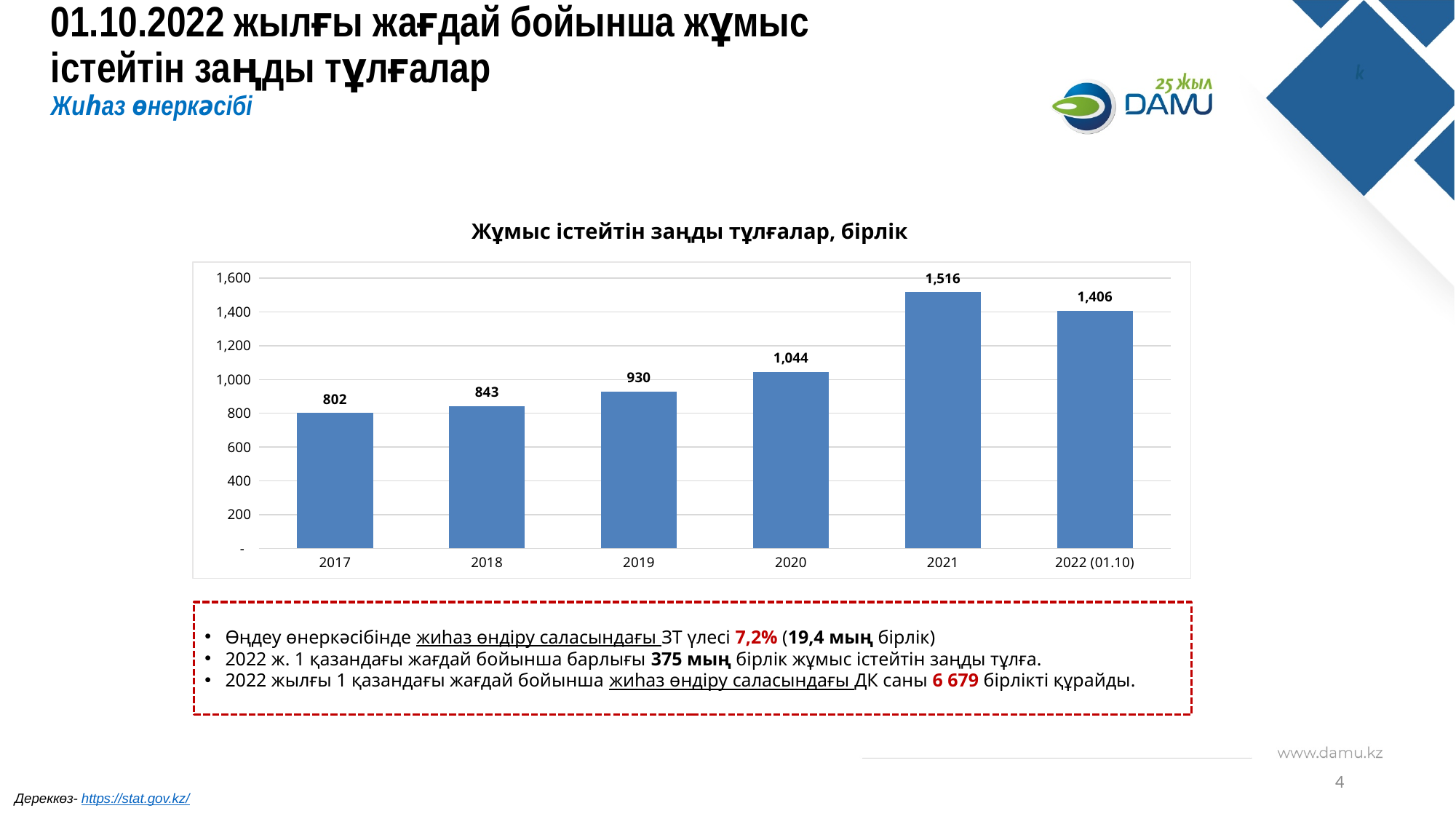
What is the title of the chart? Жұмыс істейтін заңды тұлғалар, бірлік What is the difference between the values for 2021 and 2022 (01.10)? 110 What kind of chart is shown on the slide? bar chart Which year has the lowest value? 2017 Which is larger, the value for 2019 or the value for 2020? 2020 What is the difference between the values for 2019 and 2018? 87 How many categories are shown on the x axis? 6 Which year has the highest value? 2021 Is the value for 2021 greater or less than 1,400? greater What is the value for 2017? 802 What is the value for 2020? 1,044 What is the value for 2022 (01.10)? 1,406